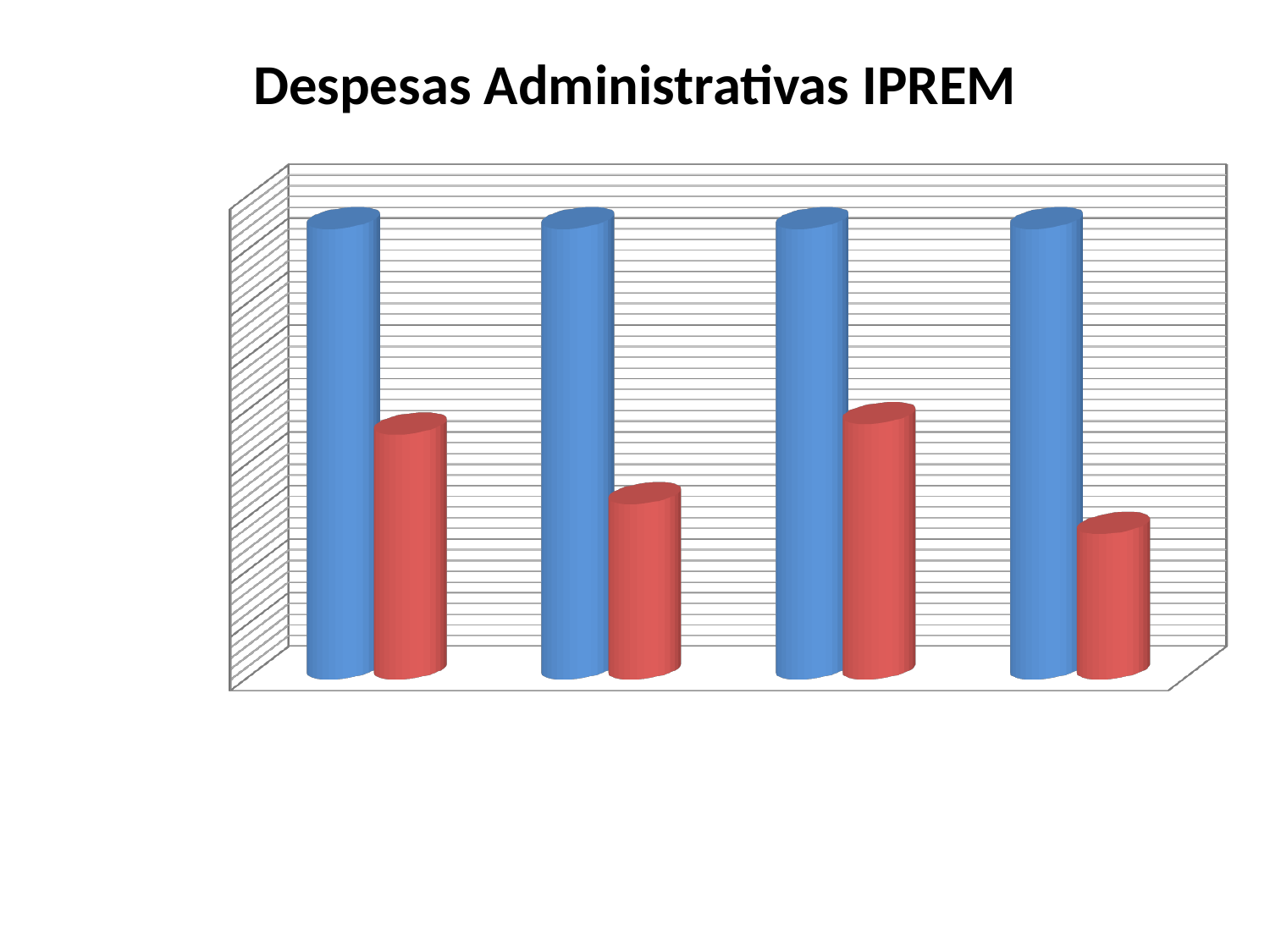
Is the red bar in the second group taller or shorter than the red bar in the first group? shorter How many groups of bars are plotted in the chart? 4 What is the title of the chart? Despesas Administrativas IPREM In the fourth group of bars, which bar is shorter, the blue one or the red one? the red one In the first group of bars, which bar is taller, the blue one or the red one? the blue one Among the red bars, which group has the shortest red bar? the fourth group Among the red bars, which group has the tallest red bar? the third group How many differently coloured bar series are plotted in the chart? 2 What kind of chart is shown on the slide? bar chart